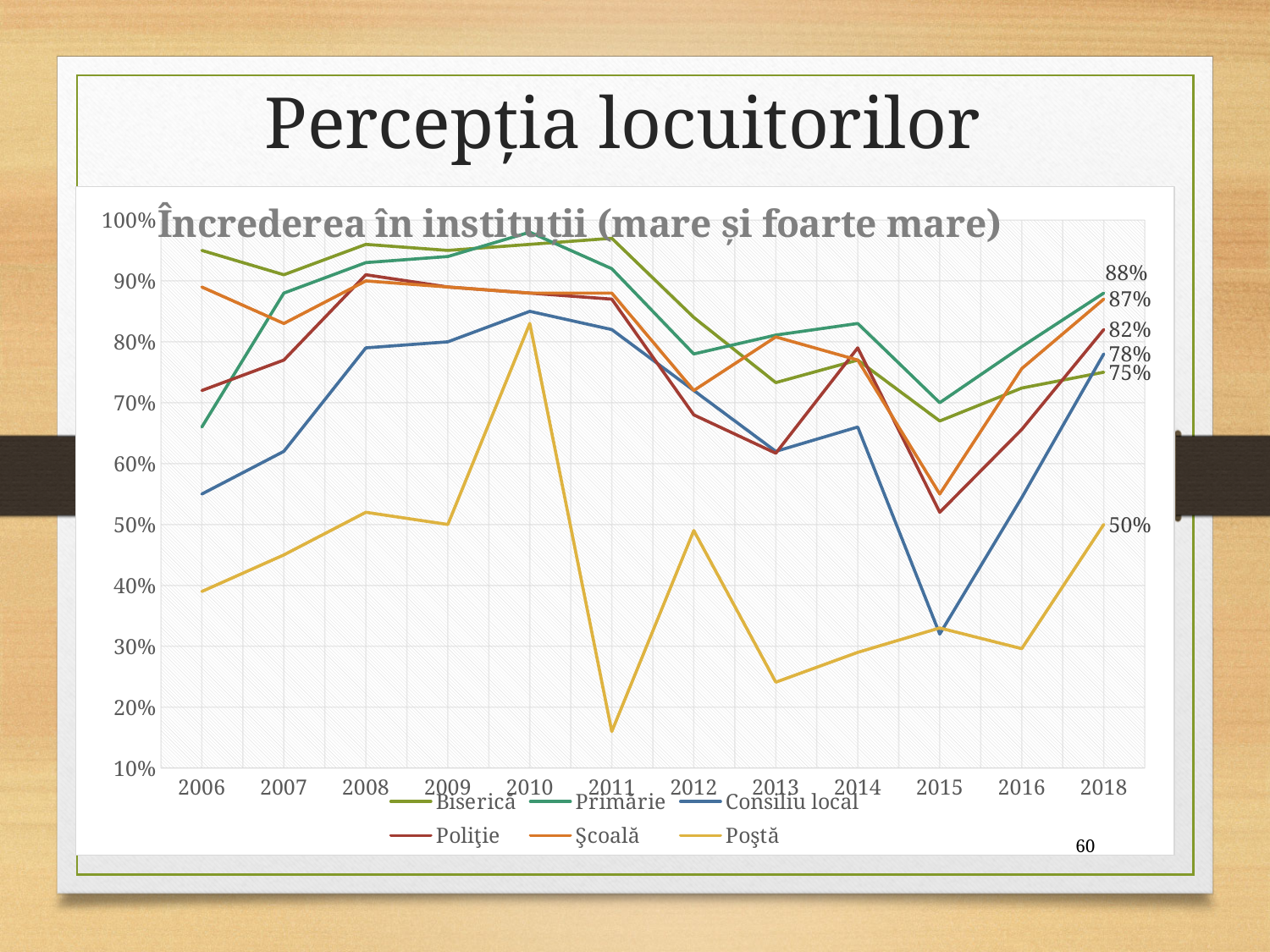
What is the difference between the 2018 values for Poliţie and Poştă? 32 percentage points What kind of chart is shown on the slide? Line chart Is the value for Biserica in 2006 greater or less than 90%? greater What is the value for Poliţie in 2018? 82% What is the value for Poştă in 2018? 50% Does the value for Biserica rise or fall from 2011 to 2015? fall What is the value for Biserica in 2018? 75% What is the title of the chart? Încrederea în instituții (mare și foarte mare) Is the value for Poştă in 2011 greater or less than 20%? less Which institution has the lowest value in 2018? Poştă How many years are shown on the x axis? 12 How many series does the legend list? 6